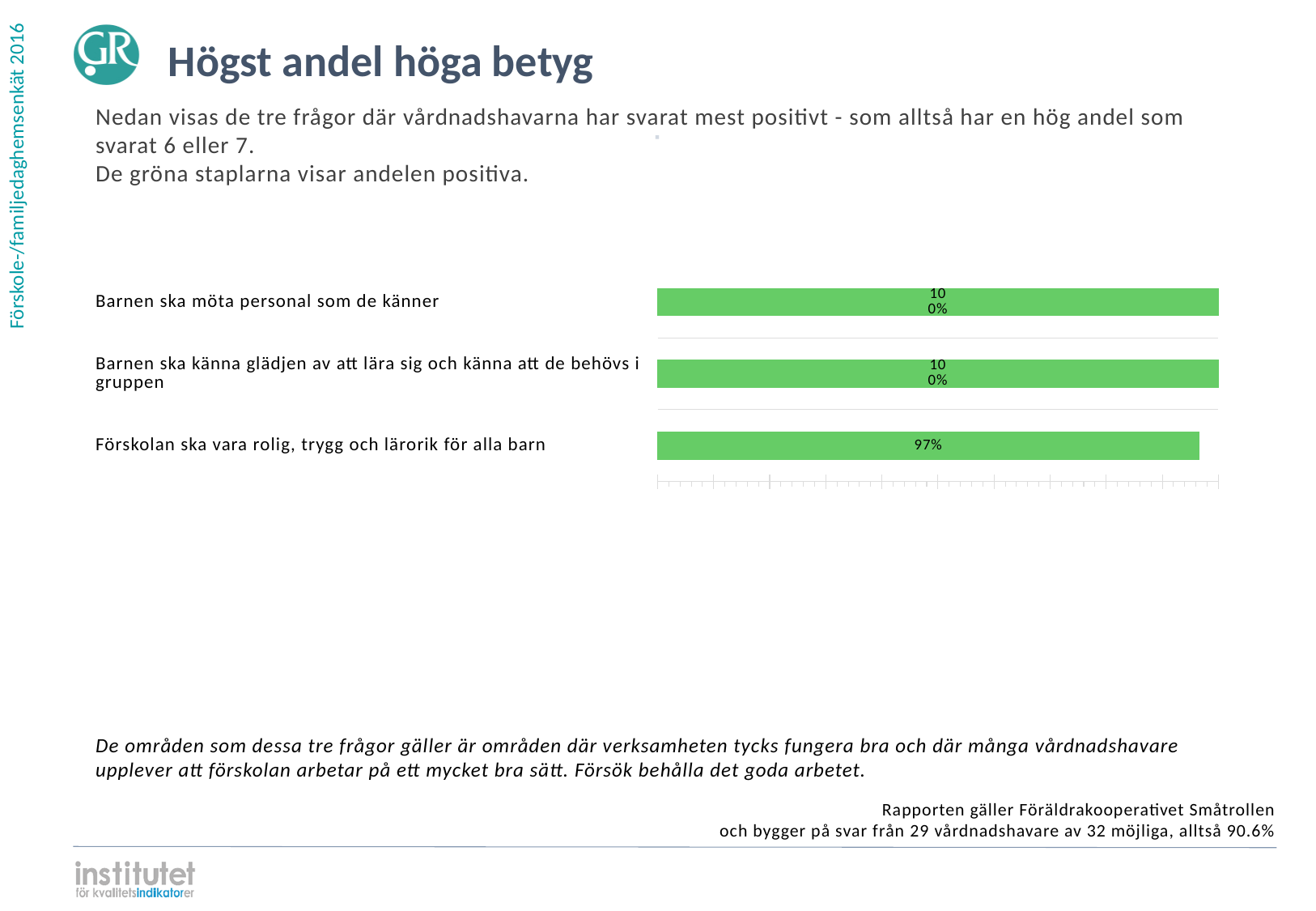
Which is larger: the value for "Barnen ska möta personal som de känner" or the value for "Förskolan ska vara rolig, trygg och lärorik för alla barn"? Barnen ska möta personal som de känner What is the difference between the value for "Barnen ska möta personal som de känner" and the value for "Förskolan ska vara rolig, trygg och lärorik för alla barn"? 3% What is the value for "Förskolan ska vara rolig, trygg och lärorik för alla barn"? 97% Do the two categories "Barnen ska möta personal som de känner" and "Barnen ska känna glädjen av att lära sig och känna att de behövs i gruppen" have the same value? Yes How many categories are shown in the chart? 3 What colour are the bars in the chart? Green What is the value for "Barnen ska möta personal som de känner"? 100% Which category has the lowest value? Förskolan ska vara rolig, trygg och lärorik för alla barn What kind of chart is shown on the slide? Bar chart What is the title of the slide containing the chart? Högst andel höga betyg What is the value for "Barnen ska känna glädjen av att lära sig och känna att de behövs i gruppen"? 100%